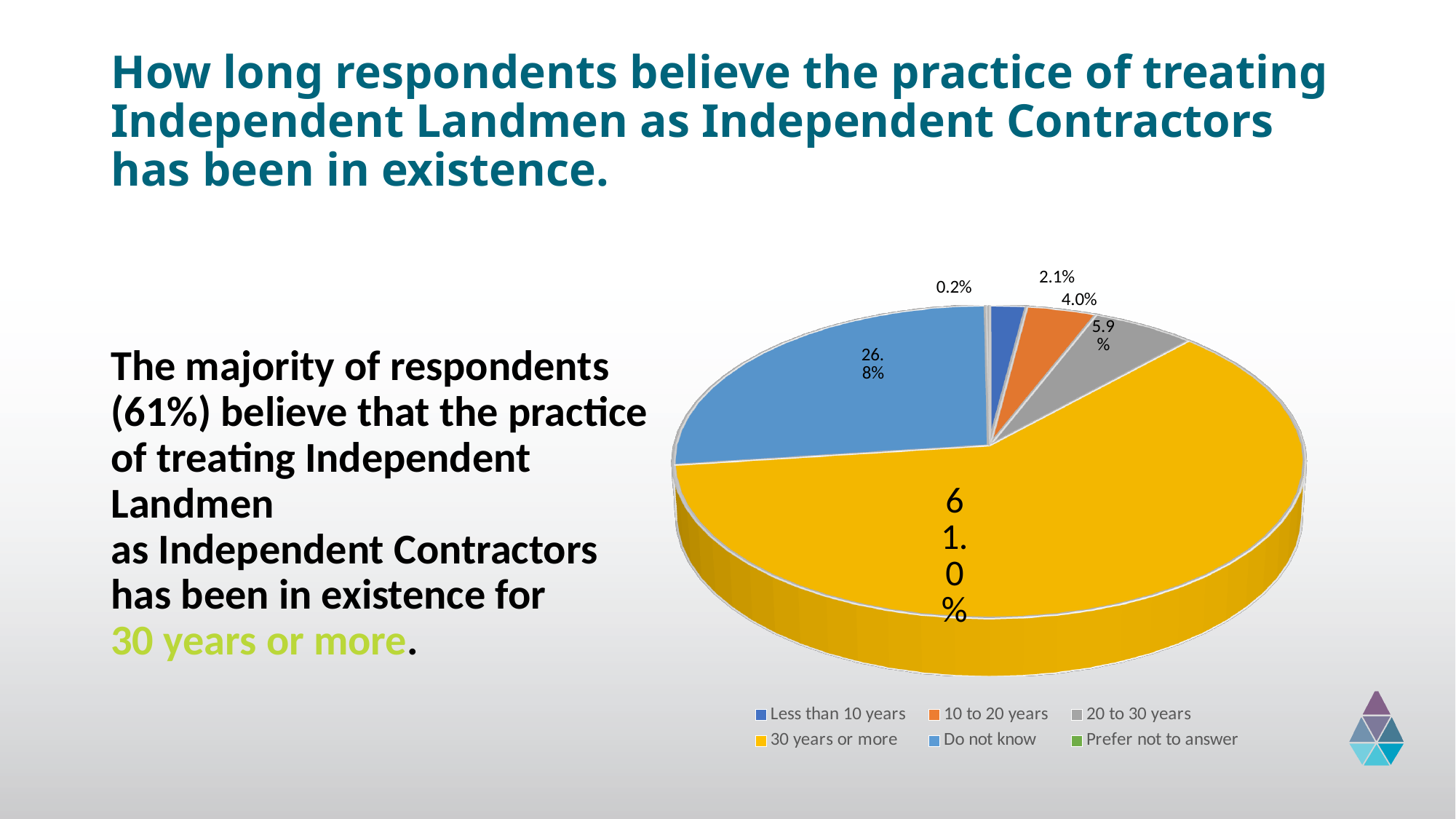
Which is larger, the share for "20 to 30 years" or the share for "10 to 20 years"? 20 to 30 years Which category has the largest share of the pie? 30 years or more What percentage of respondents chose "Less than 10 years"? 2.1% What kind of chart is shown on the slide? pie chart What colour is the slice for "30 years or more"? yellow What percentage of respondents believe the practice has been in existence for 30 years or more? 61.0% What percentage of respondents chose "10 to 20 years"? 4.0% What percentage of respondents answered "Do not know"? 26.8% How many categories does the legend list? 6 What is the difference in percentage points between "30 years or more" and "Do not know"? 34.2 What percentage of respondents chose "20 to 30 years"? 5.9% Which category has the smallest share of the pie? Prefer not to answer